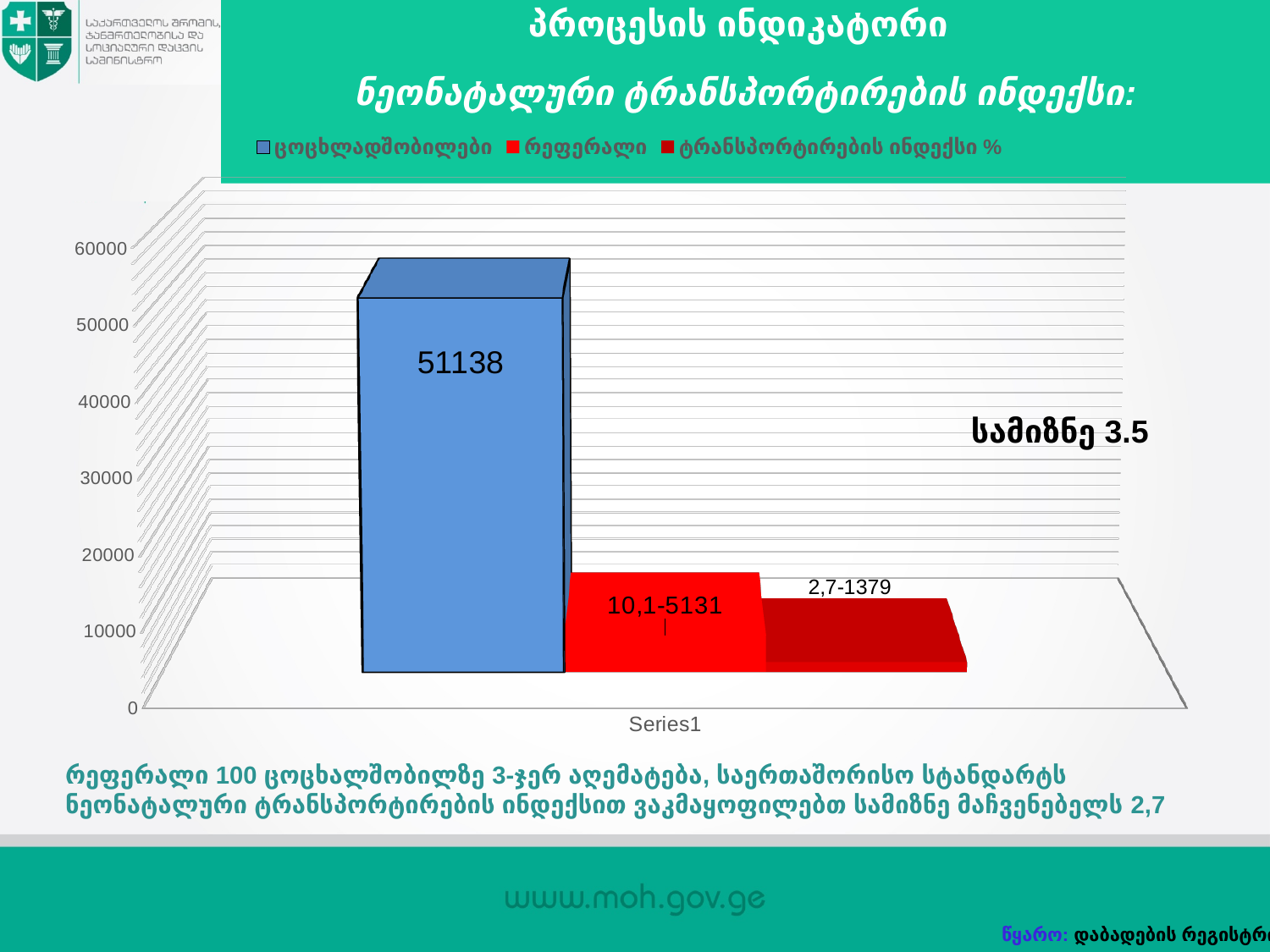
Is the value for ცოცხლადშობილები greater or less than 40000? greater How many categories are shown on the x axis? 1 Is the value for რეფერალი greater or less than 10000? less What value is shown on the ცოცხლადშობილები bar? 51138 Which bar is taller, ცოცხლადშობილები or რეფერალი? ცოცხლადშობილები What data label is printed on the ტრანსპორტირების ინდექსი % bar? 2,7-1379 Which series has the shortest bar? ტრანსპორტირების ინდექსი % What kind of chart is shown on the slide? bar chart Which series has the tallest bar? ცოცხლადშობილები How many series does the legend list? 3 What data label is printed on the რეფერალი bar? 10,1-5131 What is the category label shown on the x axis? Series1